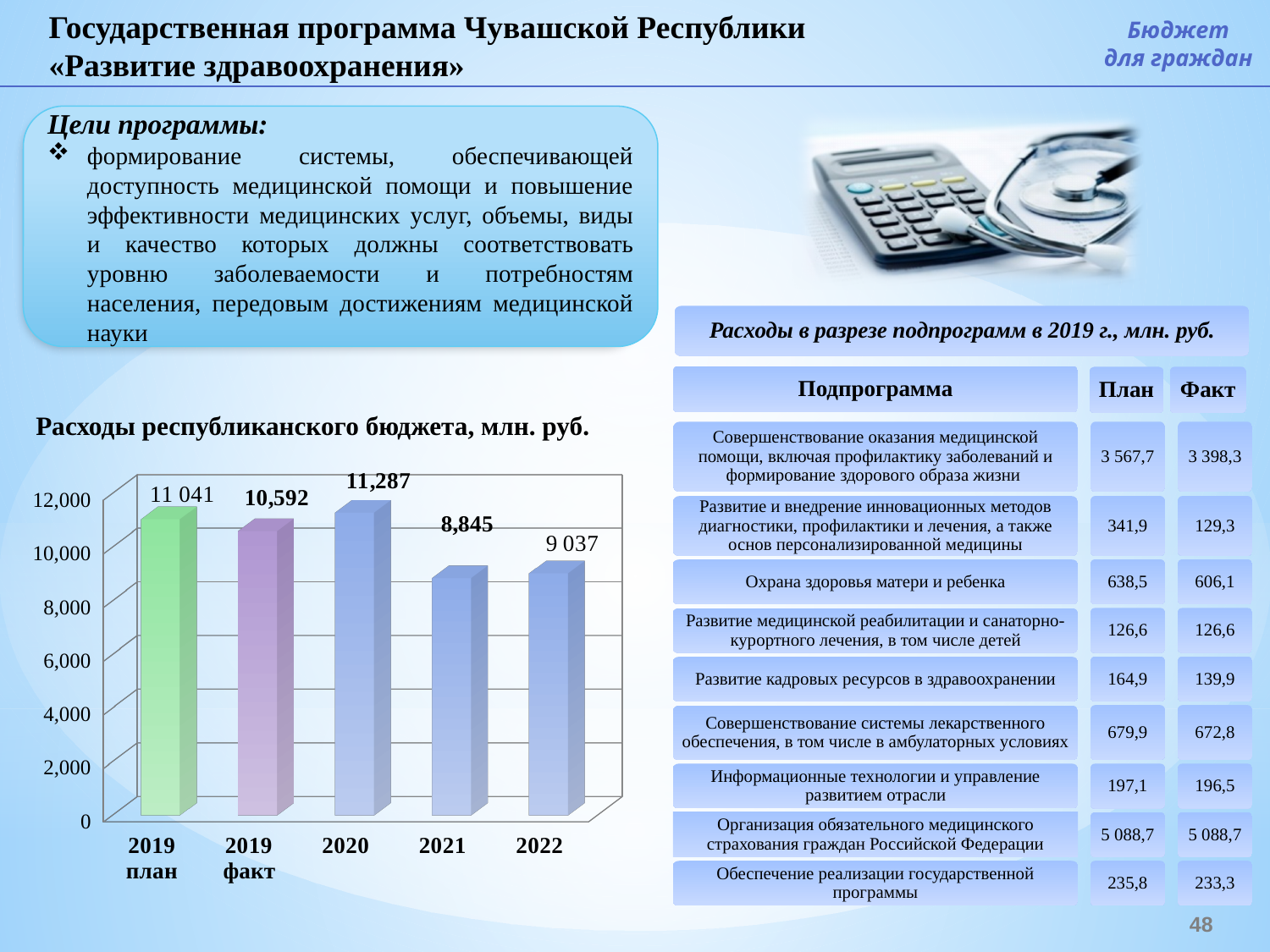
In the chart 'Расходы республиканского бюджета, млн. руб.', what is the difference between the 2020 and 2021 values? 2,442 In the chart 'Расходы республиканского бюджета, млн. руб.', what is the difference between the 2019 план and 2019 факт values? 449 What is the value for 2020 in the chart 'Расходы республиканского бюджета, млн. руб.'? 11,287 What kind of chart is 'Расходы республиканского бюджета, млн. руб.'? bar chart What is the value for 2022 in the chart 'Расходы республиканского бюджета, млн. руб.'? 9 037 Which category has the highest value in the chart 'Расходы республиканского бюджета, млн. руб.'? 2020 How many bars are shown in the chart 'Расходы республиканского бюджета, млн. руб.'? 5 Which category has the lowest value in the chart 'Расходы республиканского бюджета, млн. руб.'? 2021 What is the value for 2019 факт in the chart 'Расходы республиканского бюджета, млн. руб.'? 10,592 In the chart 'Расходы республиканского бюджета, млн. руб.', which is larger: the value for 2021 or the value for 2022? 2022 In the chart 'Расходы республиканского бюджета, млн. руб.', is the value for 2021 greater or less than 10,000? less What is the value for 2019 план in the chart 'Расходы республиканского бюджета, млн. руб.'? 11 041